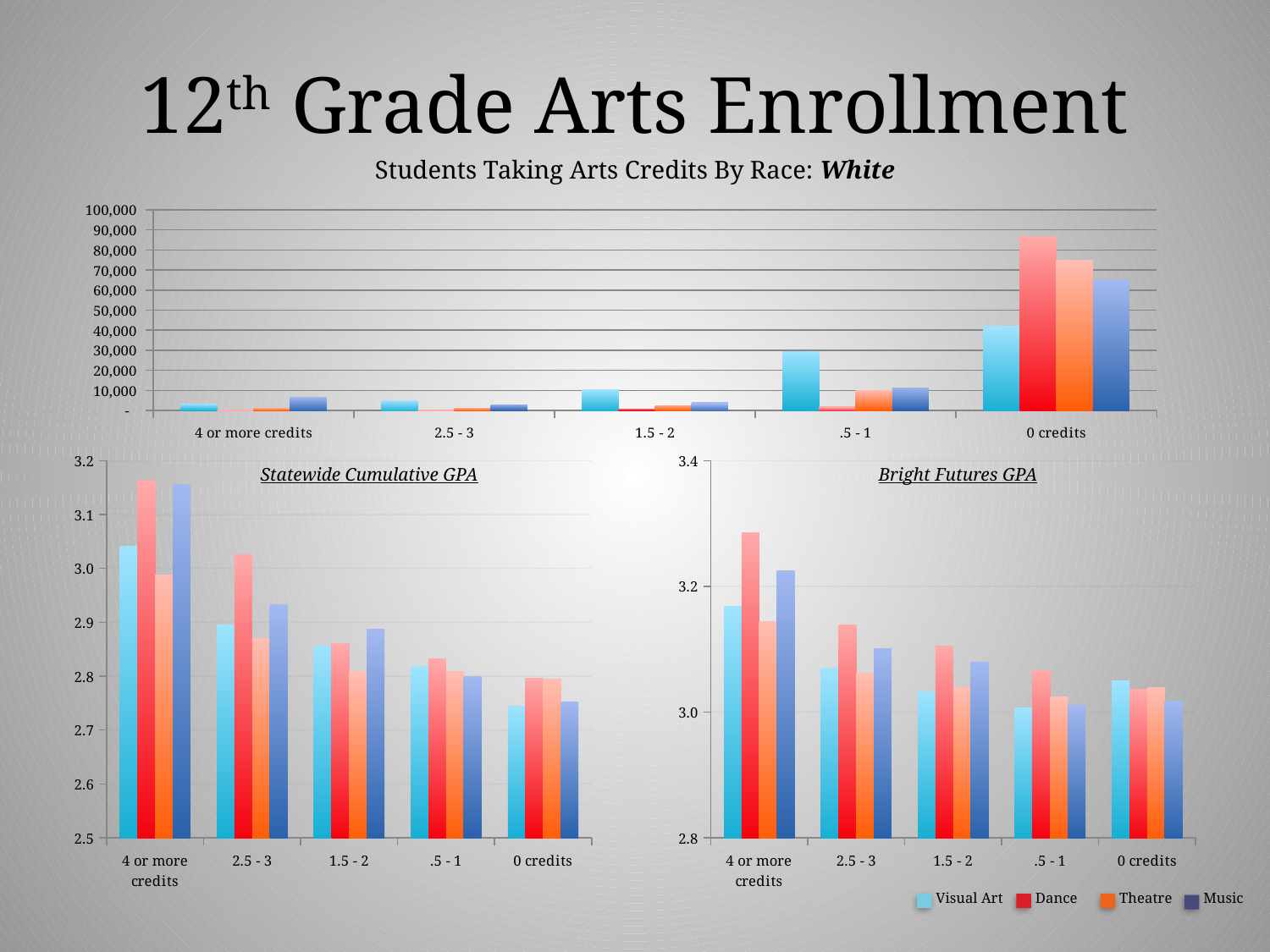
How many credit categories are shown on the x axis of the 'Statewide Cumulative GPA' chart? 5 In the top chart 'Students Taking Arts Credits By Race: White', which series has the highest value for 0 credits? Dance In the 'Statewide Cumulative GPA' chart, is the Visual Art value for 0 credits greater or less than 2.8? less In the top chart 'Students Taking Arts Credits By Race: White', is the Music value for 0 credits greater or less than 70,000? less In the 'Bright Futures GPA' chart, which series has the highest value for '4 or more credits'? Dance In the top chart 'Students Taking Arts Credits By Race: White', is the Dance value for 0 credits greater or less than 80,000? greater How many series does the legend list for the charts on this slide? 4 What kind of chart is the 'Bright Futures GPA' chart? bar chart In the 'Statewide Cumulative GPA' chart, does the Visual Art value rise or fall from '4 or more credits' to '0 credits'? fall In the top chart 'Students Taking Arts Credits By Race: White', which credit category has the tallest bars? 0 credits